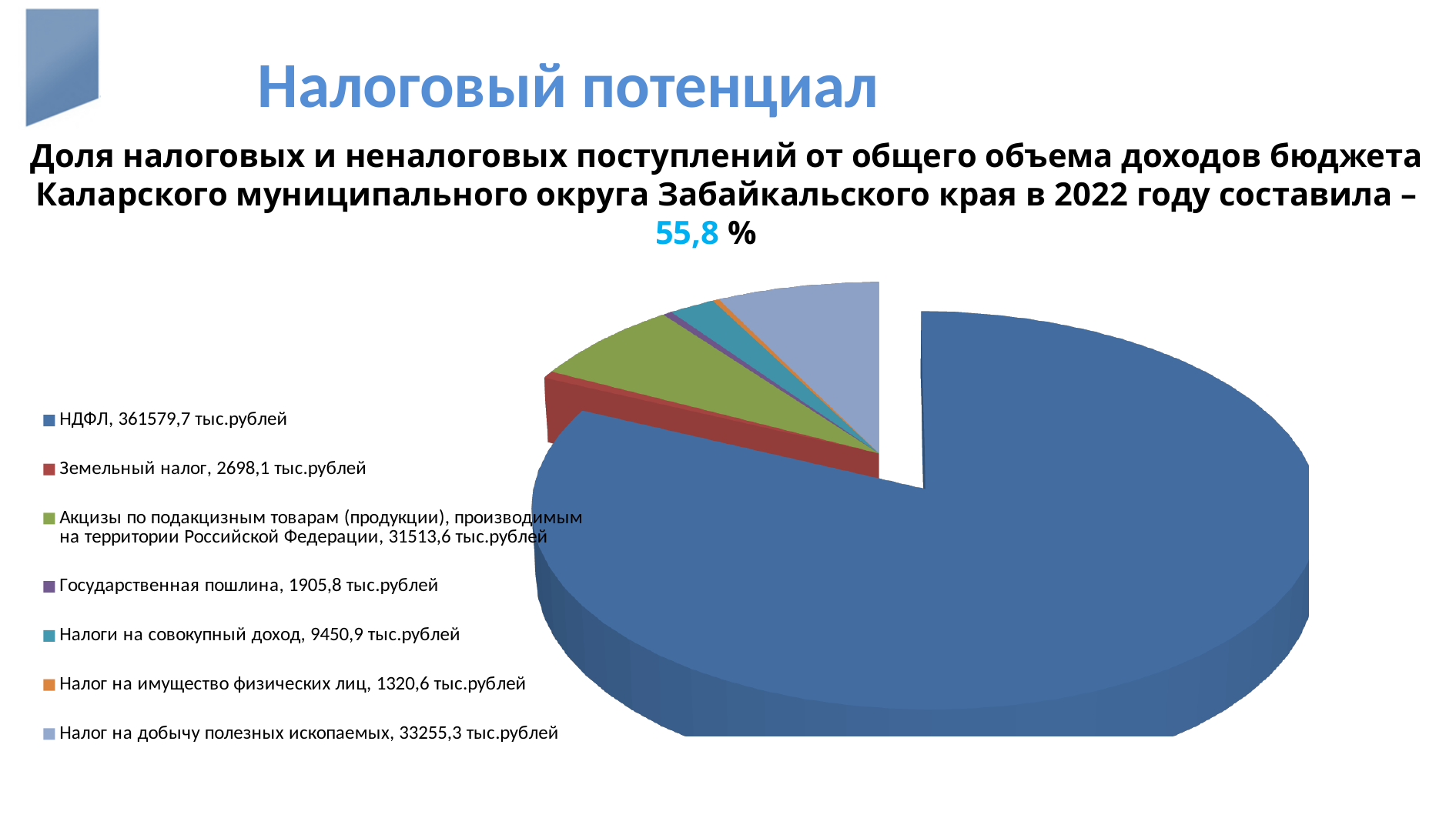
Which category has the largest value in the pie chart? НДФЛ What is the value for Государственная пошлина? 1905,8 тыс.рублей Which is larger: Налоги на совокупный доход or Земельный налог? Налоги на совокупный доход What is the title of the slide? Налоговый потенциал What is the difference between Земельный налог and Государственная пошлина? 792,3 тыс.рублей What is the value for Земельный налог? 2698,1 тыс.рублей Which category has the smallest value in the pie chart? Налог на имущество физических лиц What is the value for Налог на добычу полезных ископаемых? 33255,3 тыс.рублей How many categories does the pie chart show? 7 What is the value for НДФЛ? 361579,7 тыс.рублей What kind of chart is shown on the slide? pie chart What is the difference between Налог на добычу полезных ископаемых and Акцизы по подакцизным товарам? 1741,7 тыс.рублей